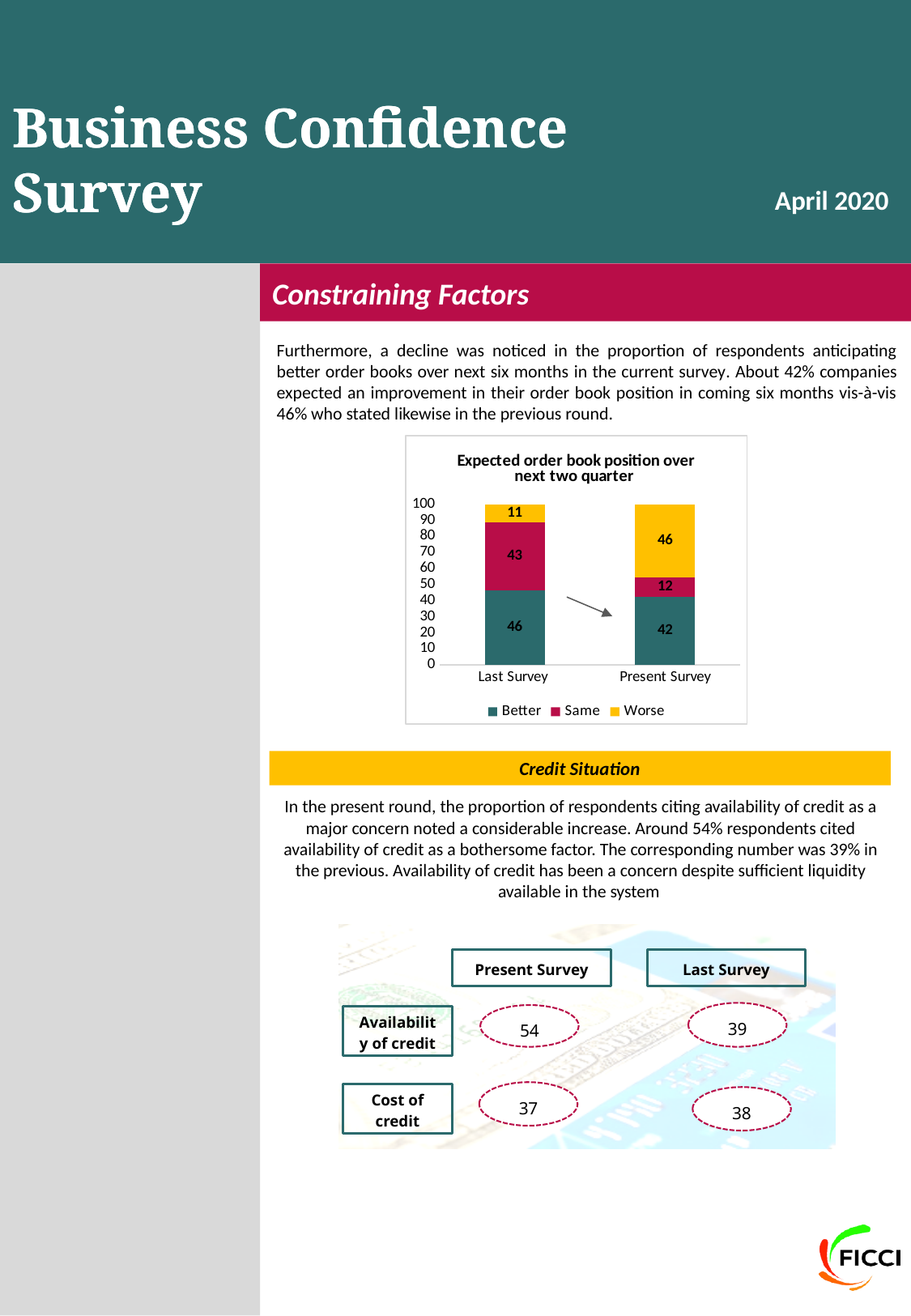
In the 'Expected order book position over next two quarter' chart, how many series does the legend list? 3 In the 'Expected order book position over next two quarter' chart, which survey has the larger Worse value? Present Survey In the 'Expected order book position over next two quarter' chart, what is the value for Same in the Present Survey? 12 What type of chart is shown under the title 'Expected order book position over next two quarter'? Stacked bar chart In the 'Expected order book position over next two quarter' chart, what is the value for Worse in the Last Survey? 11 In the 'Expected order book position over next two quarter' chart, what is the total of the stacked bar for the Last Survey? 100 In the 'Expected order book position over next two quarter' chart, what is the difference between the Same values for the Last Survey and the Present Survey? 31 In the 'Expected order book position over next two quarter' chart, what is the value for Better in the Last Survey? 46 In the 'Expected order book position over next two quarter' chart, does the Better value rise or fall from the Last Survey to the Present Survey? Fall In the 'Expected order book position over next two quarter' chart, what is the value for Worse in the Present Survey? 46 In the 'Expected order book position over next two quarter' chart, which colour represents the Worse series? Yellow In the 'Expected order book position over next two quarter' chart, how many categories are shown on the x axis? 2